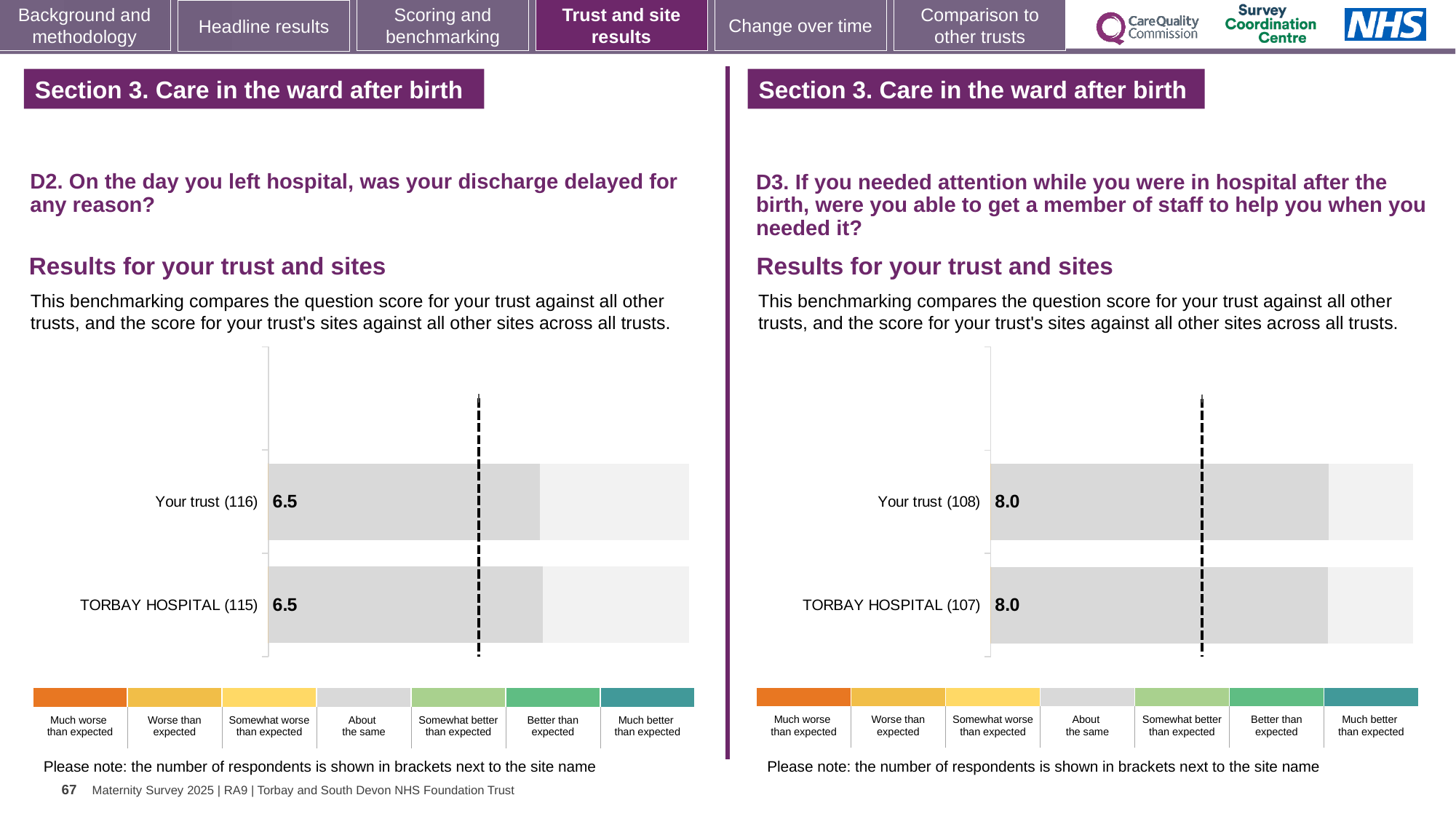
In the D3 chart on the right, how many respondents are shown in brackets for TORBAY HOSPITAL? 107 In the D2 chart on the left, what is the difference between the score for Your trust and the score for TORBAY HOSPITAL? 0.0 In the D2 chart on the left, how many respondents are shown in brackets for Your trust? 116 In the D2 chart on the left, what is the score for Your trust? 6.5 In the D3 chart on the right, what is the score for Your trust? 8.0 How many bars are plotted in the D3 chart on the right? 2 In the D3 chart on the right, what is the score for TORBAY HOSPITAL? 8.0 What kind of chart is used for the D2 results on the left? Bar chart In the D3 chart on the right, what is the difference between the score for Your trust and the score for TORBAY HOSPITAL? 0.0 How many bars are plotted in the D2 chart on the left? 2 In the D2 chart on the left, what is the score for TORBAY HOSPITAL? 6.5